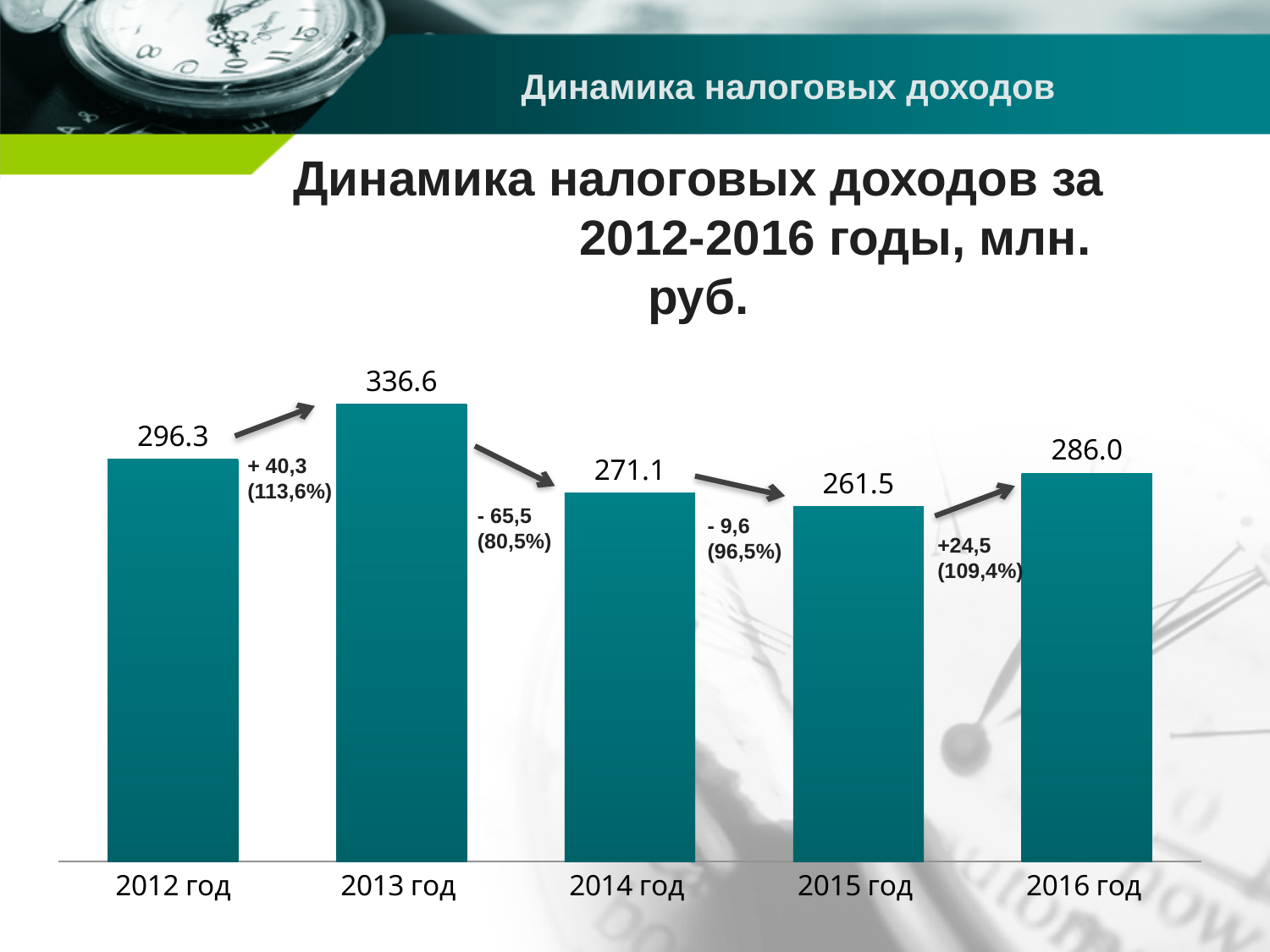
Do the values rise or fall from 2013 год to 2015 год? fall What is the value for 2013 год? 336.6 What is the difference between the values for 2013 год and 2014 год? 65.5 What kind of chart is this? bar chart What is the value for 2015 год? 261.5 Which is larger, the value for 2012 год or the value for 2016 год? 2012 год Which year has the highest value? 2013 год How many years are shown on the chart? 5 What is the difference between the values for 2016 год and 2015 год? 24.5 Which year has the lowest value? 2015 год What is the title of the chart? Динамика налоговых доходов за 2012-2016 годы, млн. руб. What is the value for 2016 год? 286.0